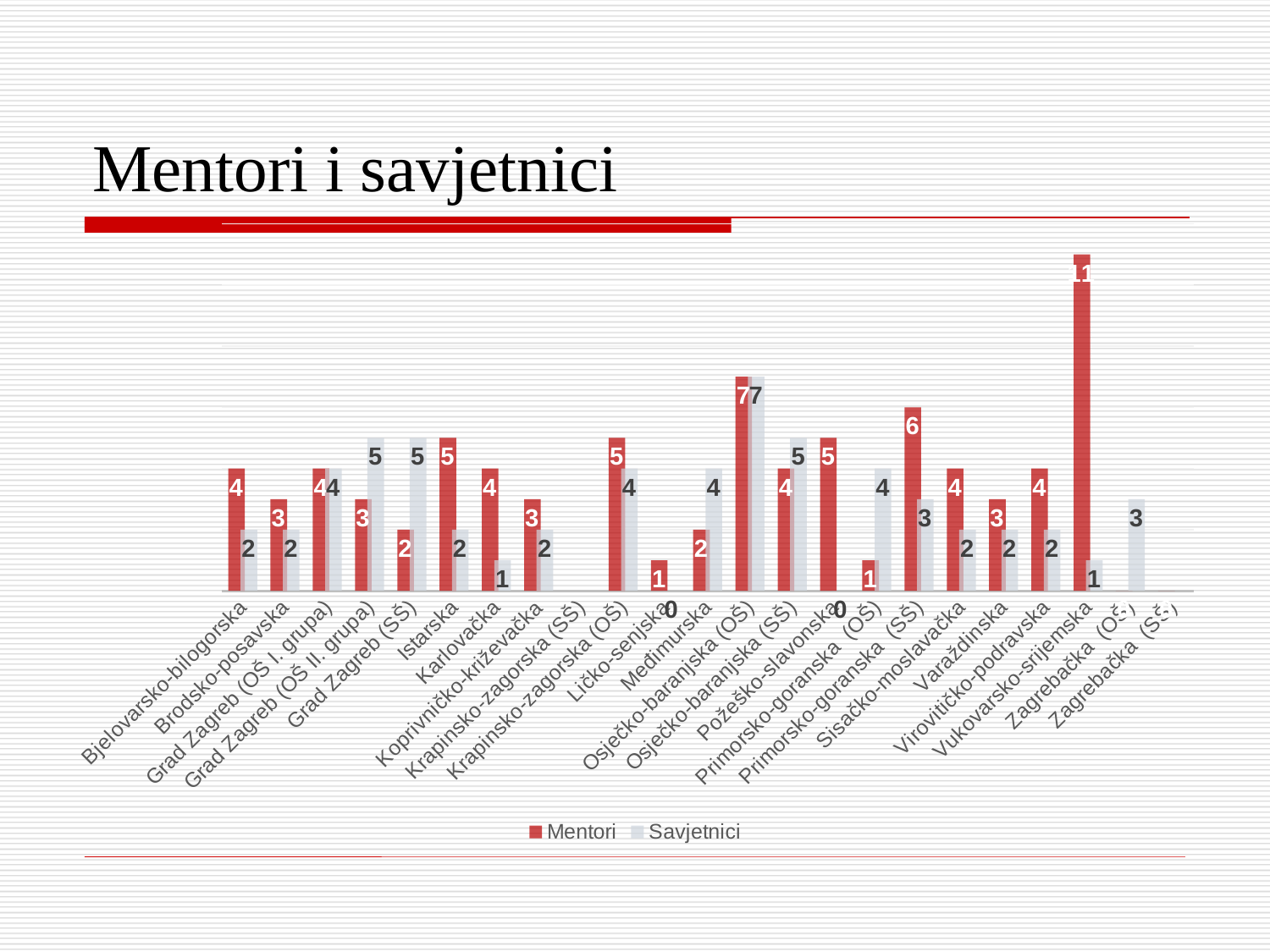
What is the Savjetnici value for Međimurska? 4 What is the Mentori value for Osječko-baranjska (OŠ)? 7 What kind of chart is shown on the slide? bar chart Which category has the highest Mentori value? Vukovarsko-srijemska What is the difference between the Mentori and Savjetnici values for Karlovačka? 3 How many series does the legend list? 2 What is the Mentori value for Istarska? 5 What is the Mentori value for Primorsko-goranska (SŠ)? 6 What is the Savjetnici value for Grad Zagreb (SŠ)? 5 For Grad Zagreb (OŠ II. grupa), which is larger: Mentori or Savjetnici? Savjetnici What are the two series named in the legend? Mentori and Savjetnici Which category has the highest Savjetnici value? Osječko-baranjska (OŠ)